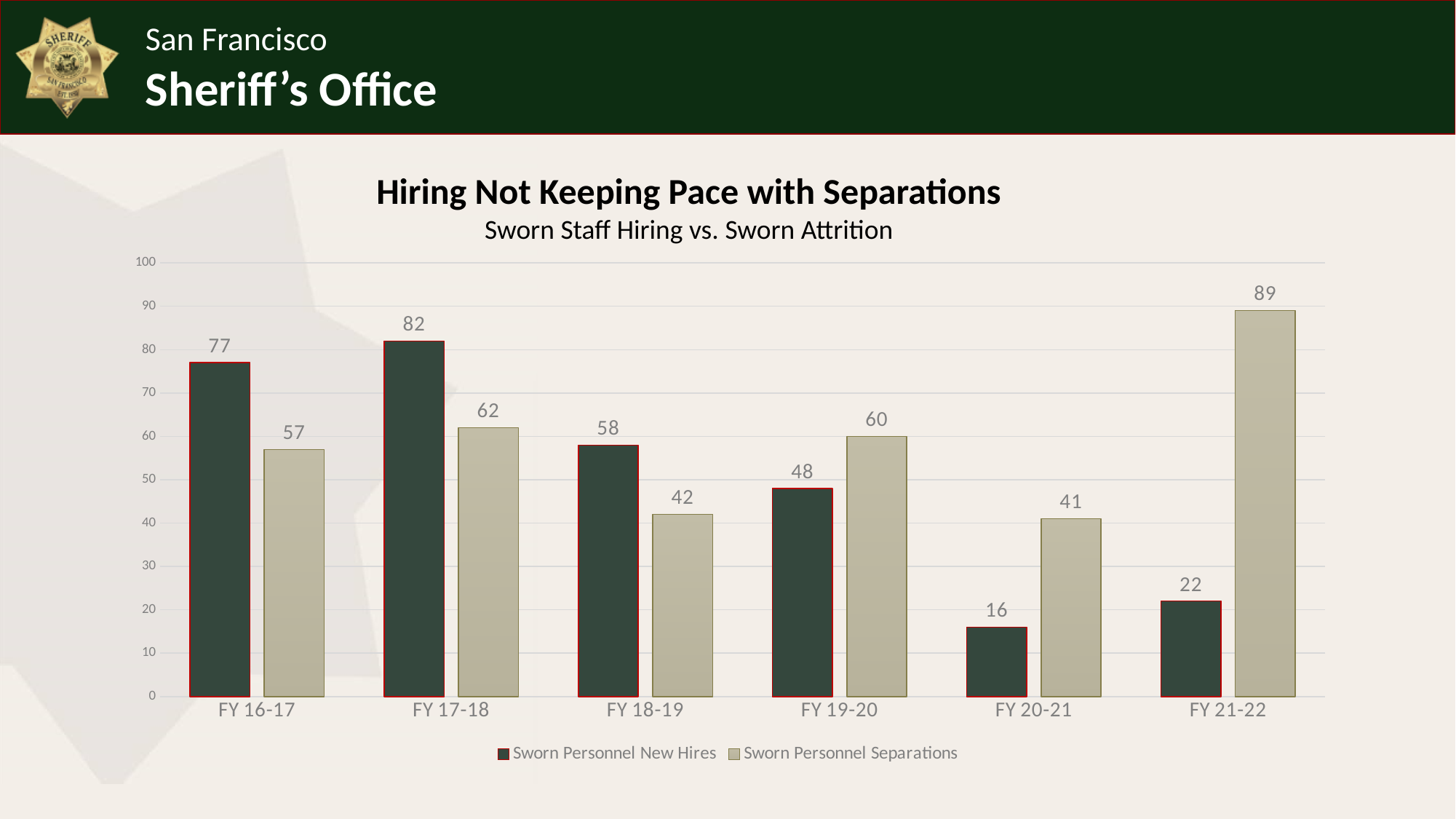
What is the value for Sworn Personnel New Hires in FY 20-21? 16 In FY 18-19, which is larger: Sworn Personnel New Hires or Sworn Personnel Separations? Sworn Personnel New Hires In which fiscal year were Sworn Personnel Separations highest? FY 21-22 What is the title of the chart? Hiring Not Keeping Pace with Separations What is the difference between Sworn Personnel Separations and Sworn Personnel New Hires in FY 21-22? 67 Do Sworn Personnel New Hires rise or fall from FY 17-18 to FY 20-21? Fall How many fiscal years are shown on the x axis? 6 What is the value for Sworn Personnel New Hires in FY 17-18? 82 How many series does the legend list? 2 What is the value for Sworn Personnel Separations in FY 21-22? 89 What kind of chart is shown on the slide? Bar chart In which fiscal year were Sworn Personnel New Hires lowest? FY 20-21